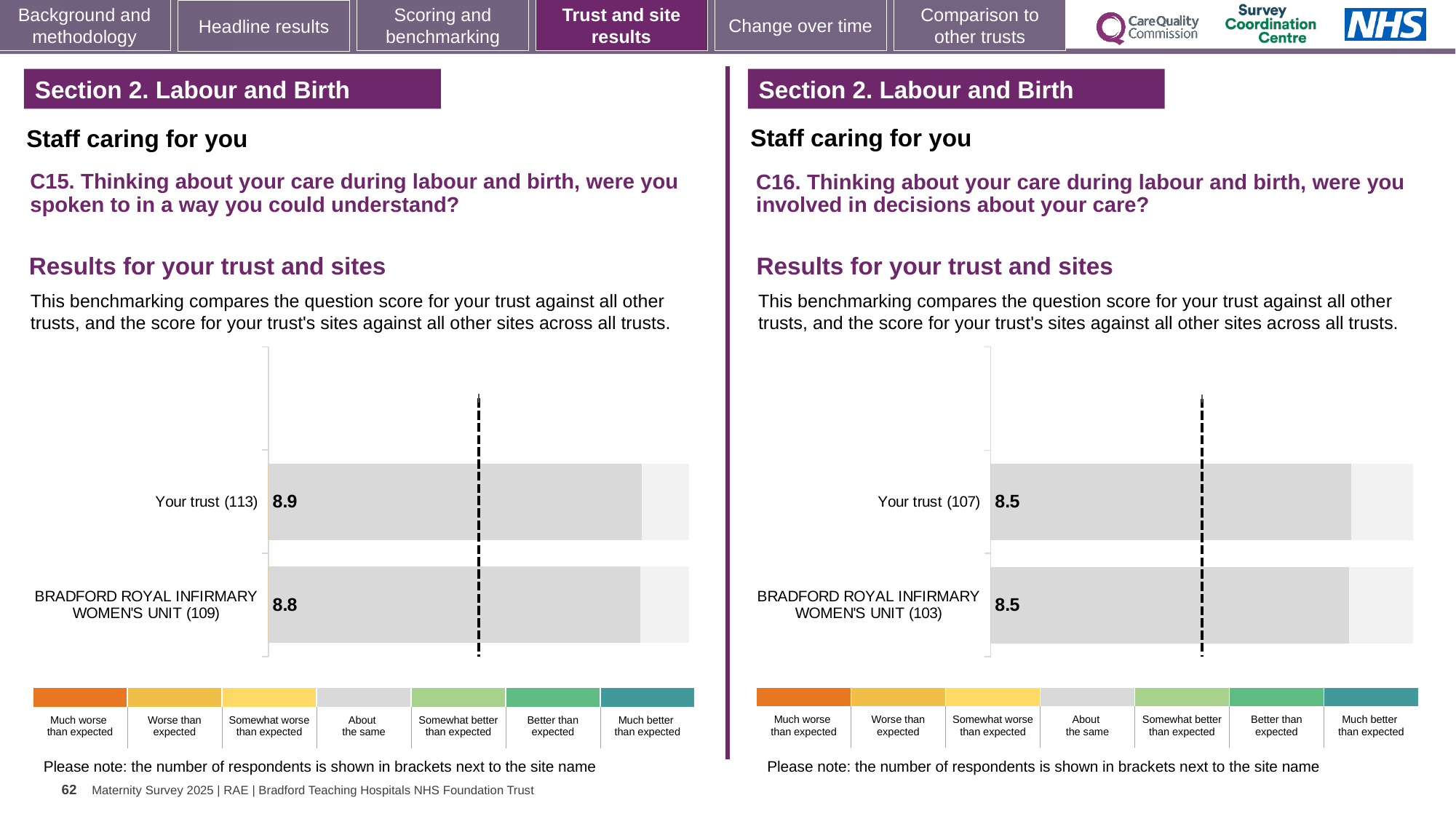
In the C15 chart on the left, what is the difference between the score for Your trust and the score for Bradford Royal Infirmary Women's Unit? 0.1 In the C16 chart on the right, what is the difference between the score for Your trust and the score for Bradford Royal Infirmary Women's Unit? 0 In the C15 chart on the left, what is the score for Your trust? 8.9 In the C16 chart on the right, what is the score for Bradford Royal Infirmary Women's Unit? 8.5 What type of chart is used for the C16 results on the right? Bar chart In the C16 chart on the right, what is the score for Your trust? 8.5 In the C16 chart on the right, how many respondents are shown in brackets for Bradford Royal Infirmary Women's Unit? 103 In the C15 chart on the left, how many respondents are shown in brackets for Your trust? 113 In the C15 chart on the left, which category has the lowest score? Bradford Royal Infirmary Women's Unit In the C15 chart on the left, which has the higher score: Your trust or Bradford Royal Infirmary Women's Unit? Your trust In the C15 chart on the left, what is the score for Bradford Royal Infirmary Women's Unit? 8.8 How many bars are plotted in the C15 chart on the left? 2